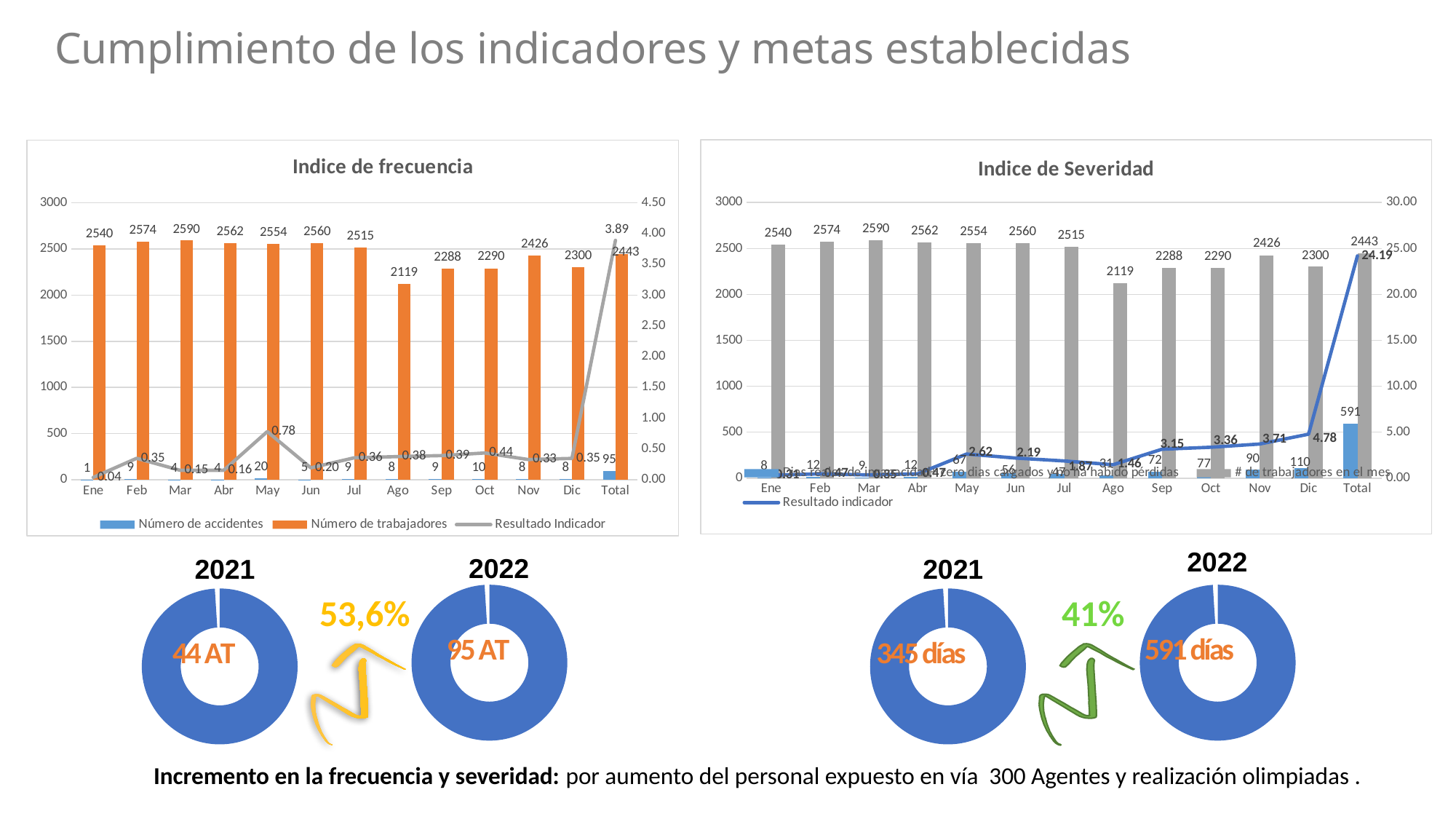
In the 'Indice de Severidad' chart, what is the Resultado indicador value for Dic? 4.78 In the 'Indice de Severidad' chart, what is the value of the blue bar for Total? 591 In the 'Indice de frecuencia' chart, what is the Resultado Indicador value for Total? 3.89 In the 2022 donut chart on the left side of the slide, what value is shown in the centre? 95 AT In the 'Indice de frecuencia' chart, how many series does the legend list? 3 In the 'Indice de Severidad' chart, which is larger, the Resultado indicador for Sep or for Jul? Sep In the 'Indice de Severidad' chart, how many categories are shown on the x axis? 13 In the 'Indice de frecuencia' chart, what is the Número de trabajadores value for Mar? 2590 In the 'Indice de Severidad' chart, does the Resultado indicador line rise or fall from Sep to Dic? rise In the 'Indice de frecuencia' chart, what is the difference between the Número de trabajadores for Mar and Ago? 471 In the 'Indice de frecuencia' chart, what is the Resultado Indicador value for May? 0.78 In the 'Indice de frecuencia' chart, which month has the lowest Número de trabajadores? Ago